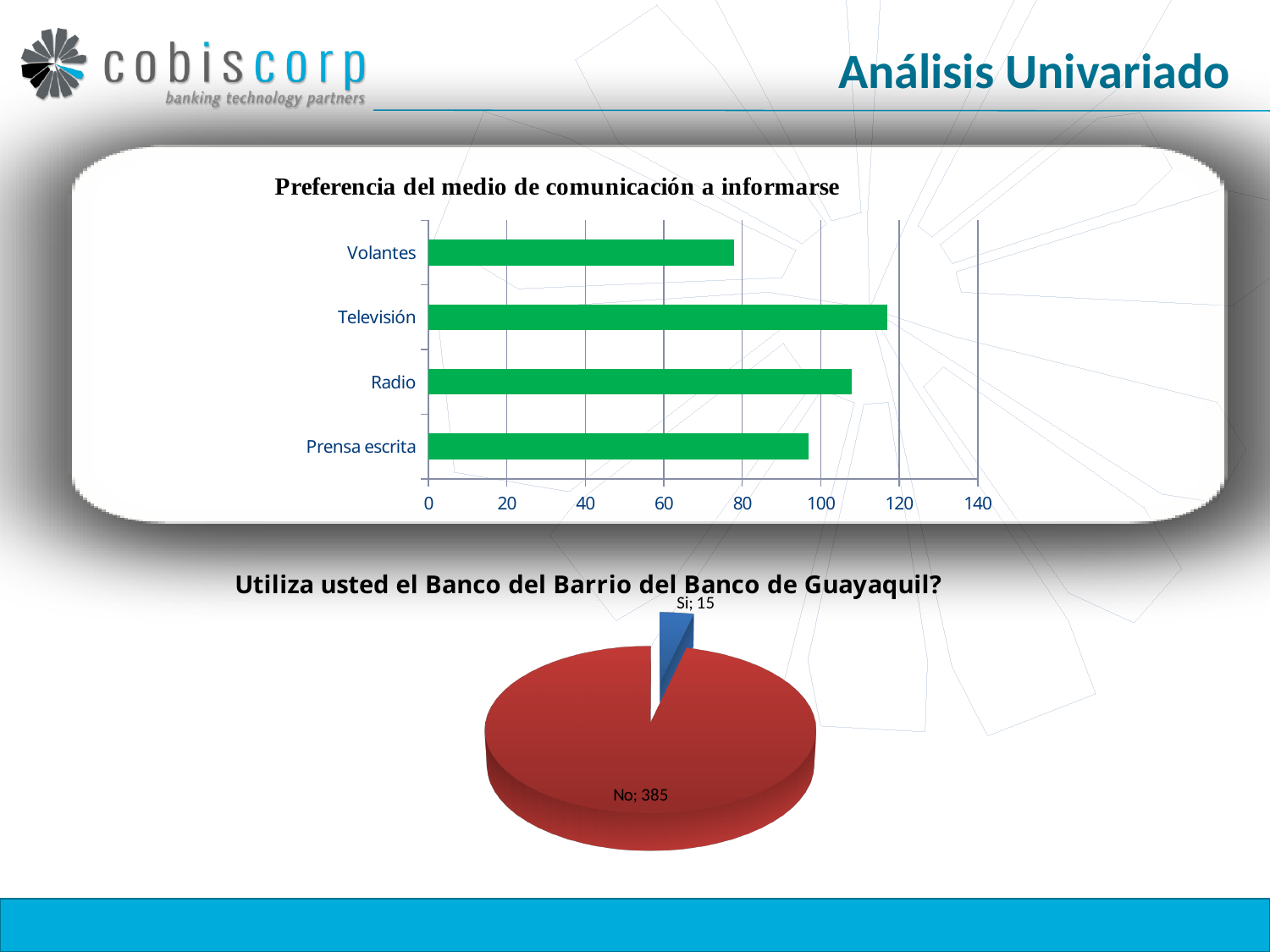
In the chart 'Preferencia del medio de comunicación a informarse', is the value for Televisión greater or less than 100? greater In the chart 'Preferencia del medio de comunicación a informarse', which is larger, the value for Radio or the value for Prensa escrita? Radio In the pie chart 'Utiliza usted el Banco del Barrio del Banco de Guayaquil?', what share of the total does the Si slice represent? 3.75% What kind of chart is 'Preferencia del medio de comunicación a informarse'? bar chart In the pie chart 'Utiliza usted el Banco del Barrio del Banco de Guayaquil?', what is the difference between the No and Si values? 370 In the chart 'Preferencia del medio de comunicación a informarse', which medium has the lowest value? Volantes In the pie chart 'Utiliza usted el Banco del Barrio del Banco de Guayaquil?', what is the value for Si? 15 How many categories are shown in the chart 'Preferencia del medio de comunicación a informarse'? 4 In the chart 'Preferencia del medio de comunicación a informarse', which medium has the highest value? Televisión In the pie chart 'Utiliza usted el Banco del Barrio del Banco de Guayaquil?', what is the value for No? 385 In the chart 'Preferencia del medio de comunicación a informarse', is the value for Volantes greater or less than 60? greater In the chart 'Preferencia del medio de comunicación a informarse', is the value for Prensa escrita greater or less than 80? greater